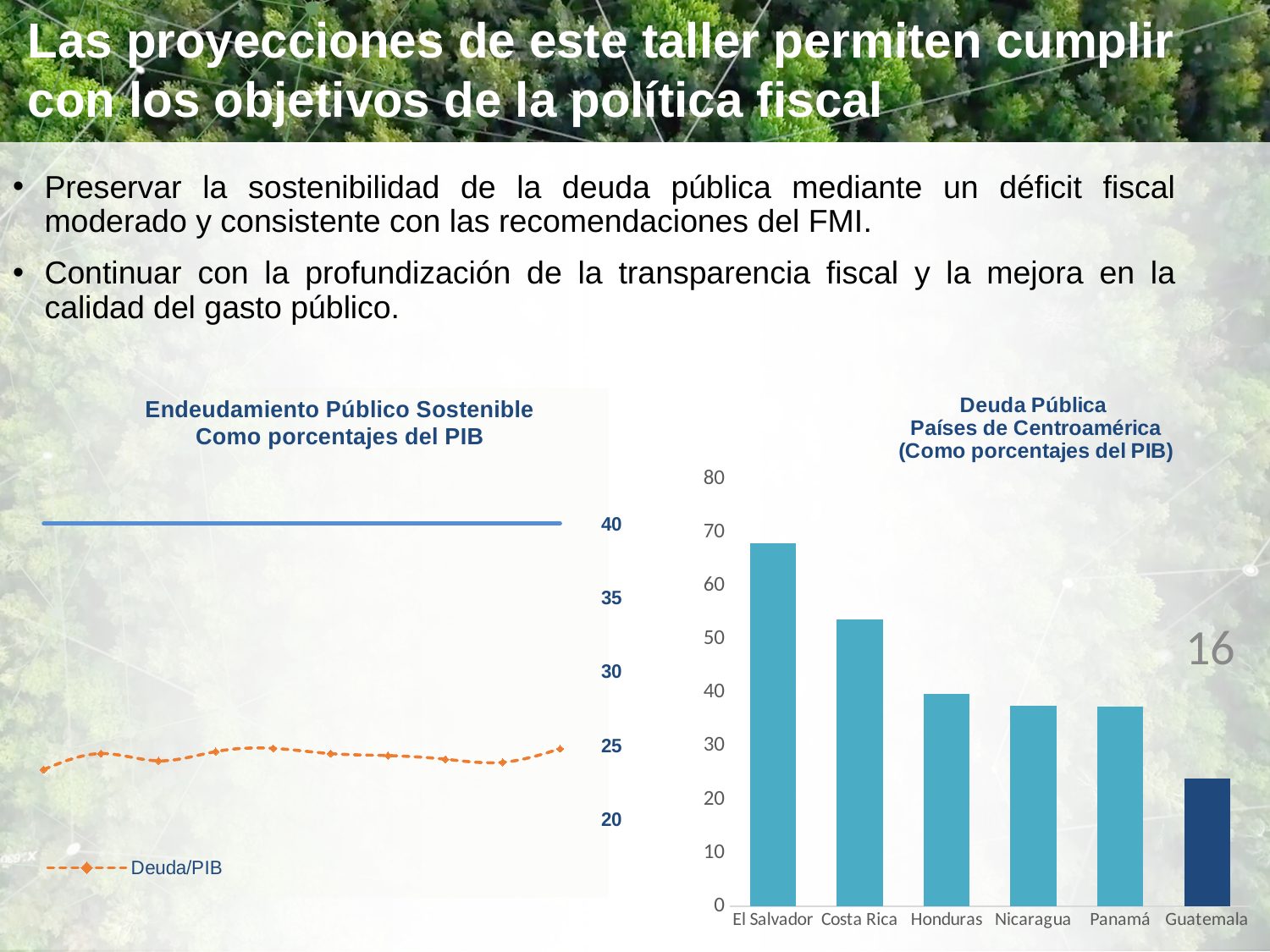
In the 'Deuda Pública Países de Centroamérica' chart, which is larger, the value for Panamá or the value for Guatemala? Panamá In the 'Deuda Pública Países de Centroamérica' chart, is the value for El Salvador greater or less than 60? greater In the 'Deuda Pública Países de Centroamérica' chart, is the value for Costa Rica greater or less than 50? greater In the 'Endeudamiento Público Sostenible' chart, are the values of the dashed Deuda/PIB line greater or less than 30? less In the 'Deuda Pública Países de Centroamérica' chart, which country has the highest value? El Salvador In the 'Endeudamiento Público Sostenible' chart, what series name does the legend show? Deuda/PIB What kind of chart is the 'Endeudamiento Público Sostenible' chart on the left of the slide? line chart In the 'Deuda Pública Países de Centroamérica' chart, how many countries are shown? 6 In the 'Deuda Pública Países de Centroamérica' chart, which country has the lowest value? Guatemala What kind of chart is the 'Deuda Pública Países de Centroamérica' chart on the right of the slide? bar chart In the 'Deuda Pública Países de Centroamérica' chart, which is larger, the value for Costa Rica or the value for Honduras? Costa Rica